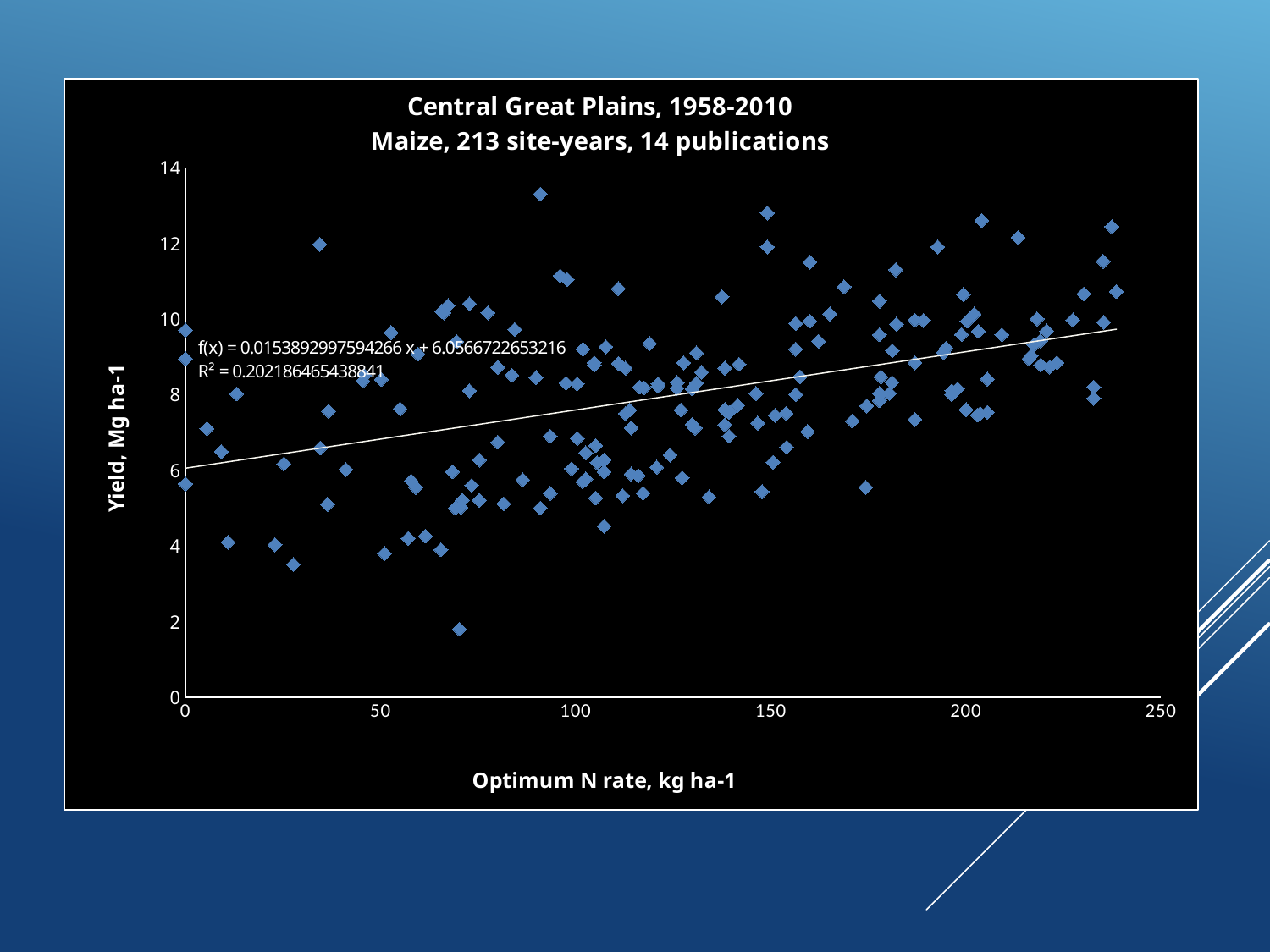
What is the maximum value shown on the x axis? 250 Is the lowest yield value plotted greater or less than 2? less What kind of chart is shown on the slide? Scatter plot What is the maximum value shown on the y axis? 14 Does yield tend to rise or fall as the optimum N rate increases along the x axis? Rise Is the highest yield value plotted greater or less than 12? greater According to the chart title, how many site-years of maize data are plotted? 213 What is the R² value shown for the trendline? 0.202186465438841 What is the equation of the trendline shown on the chart? f(x) = 0.0153892997594266 x + 6.0566722653216 What is the label of the y axis? Yield, Mg ha-1 What is the title of the chart? Central Great Plains, 1958-2010 Maize, 213 site-years, 14 publications Is the slope of the trendline positive or negative? Positive